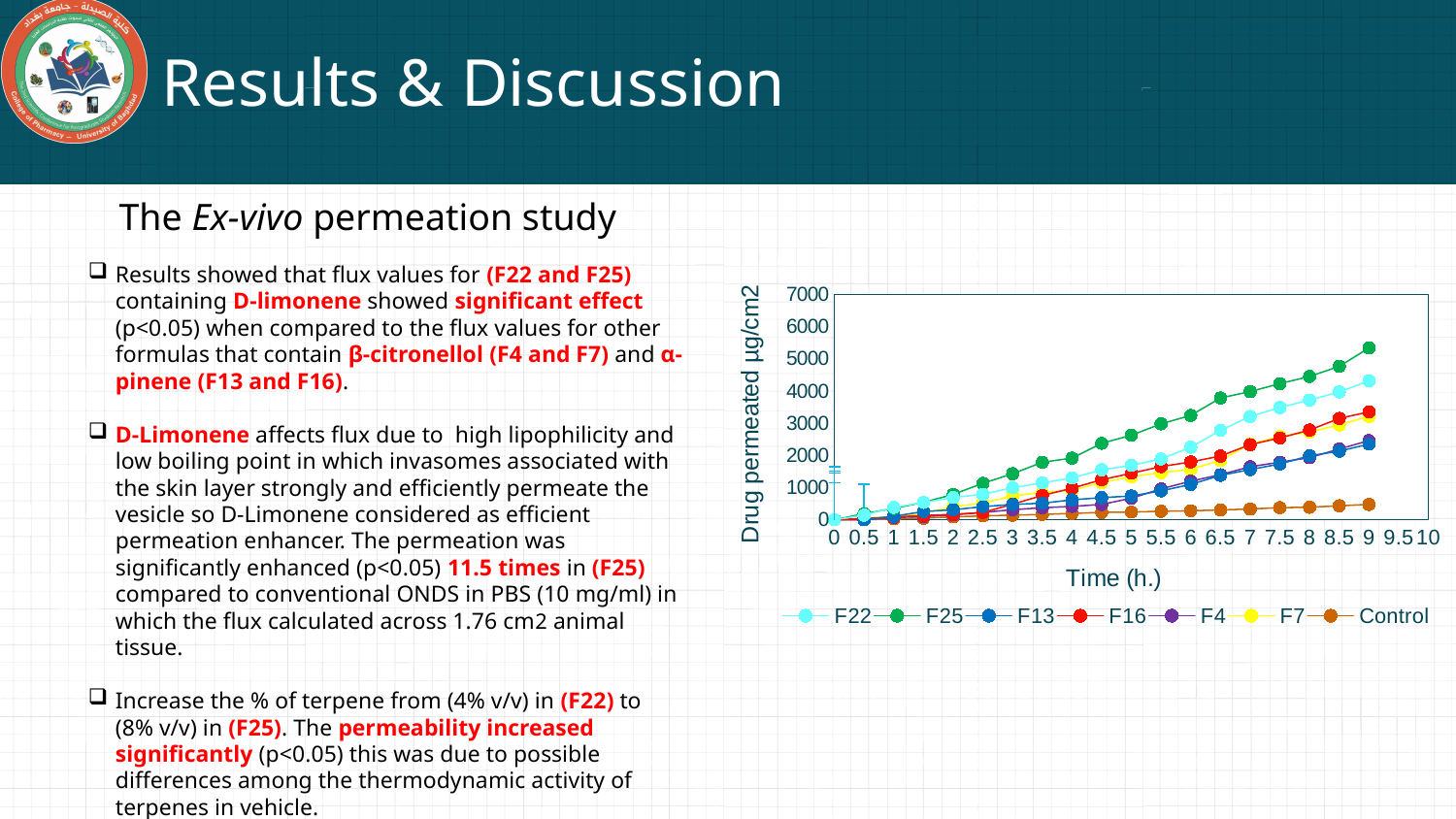
What is the title of the x axis of the chart? Time (h.) Is the value for F13 at 9 hours greater or less than 3000? less Is the value for Control at 9 hours greater or less than 1000? less Which is larger at 9 hours, the value for F22 or the value for F13? F22 Which series has the highest drug permeated value at 9 hours? F25 Is the value for F25 at 9 hours greater or less than 5000? greater Which series has the lowest drug permeated value at 9 hours? Control Which is larger at 9 hours, the value for F25 or the value for Control? F25 How many series does the legend of the chart list? 7 Do the drug permeated values for F25 rise or fall as time increases? rise What kind of chart is shown on the slide? line chart What is the title of the y axis of the chart? Drug permeated µg/cm2